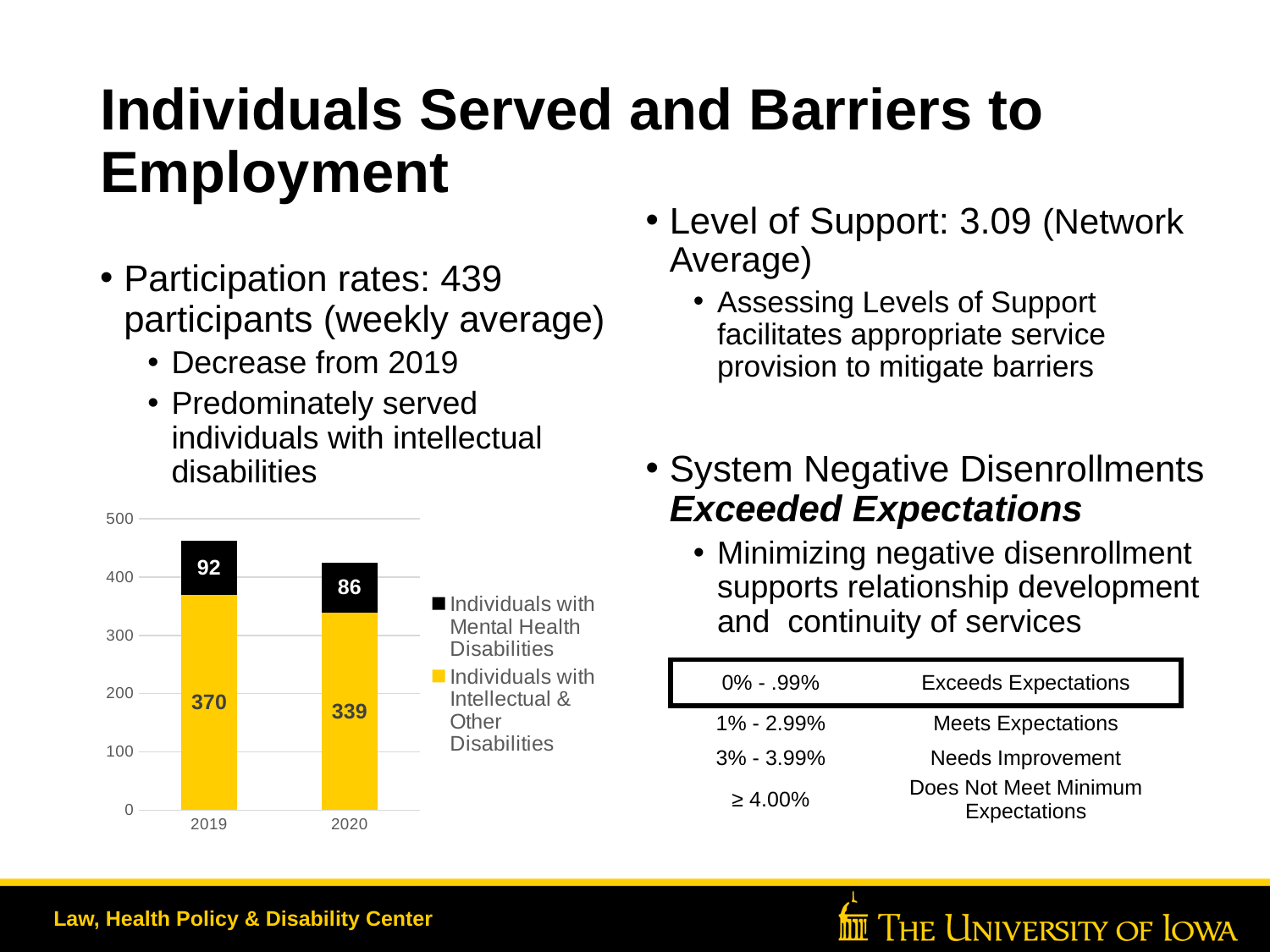
What kind of chart is shown on the slide? Stacked bar chart What is the value for Individuals with Mental Health Disabilities in 2019? 92 What is the total of the stacked bar for 2019? 462 What is the value for Individuals with Intellectual & Other Disabilities in 2019? 370 Which colour represents Individuals with Intellectual & Other Disabilities? Yellow How many categories are shown on the x axis? 2 What is the total of the stacked bar for 2020? 425 How many series does the legend list? 2 Which year has the larger value for Individuals with Mental Health Disabilities, 2019 or 2020? 2019 What is the value for Individuals with Intellectual & Other Disabilities in 2020? 339 What is the difference between the Individuals with Intellectual & Other Disabilities values for 2019 and 2020? 31 What is the value for Individuals with Mental Health Disabilities in 2020? 86